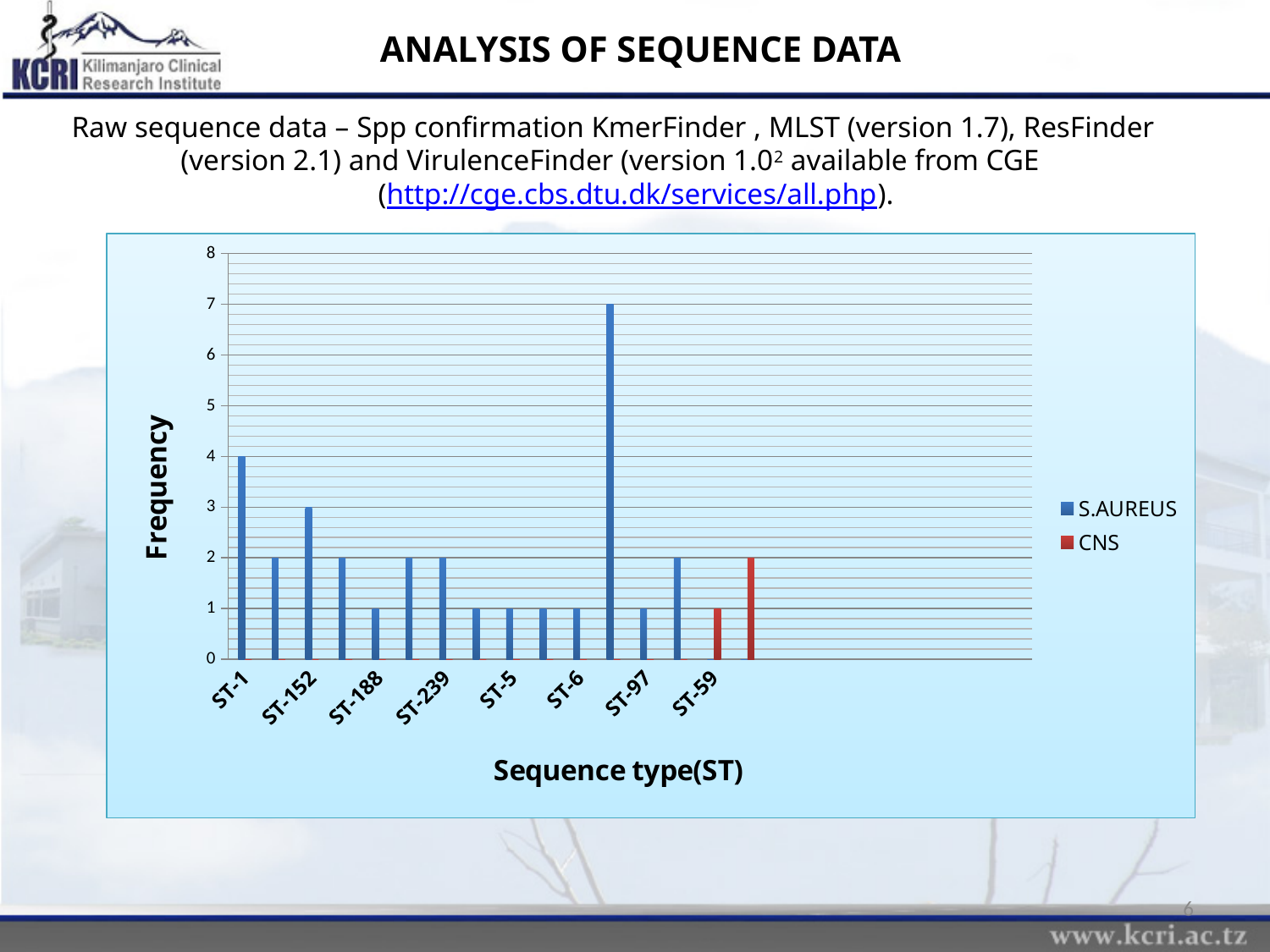
How many series does the chart legend list? 2 How many bars are plotted in the chart in total? 16 What are the two series named in the chart legend? S.AUREUS and CNS What is the title of the chart's x axis? Sequence type(ST) What type of chart is shown on the slide? bar chart Is the frequency for ST-1 greater or less than 3? greater What is the frequency for ST-152? 3 What is the difference in frequency between ST-1 and ST-152? 1 What is the highest frequency value reached by any bar in the chart? 7 Which has the larger frequency, ST-1 or ST-152? ST-1 What is the frequency for ST-1? 4 What is the frequency for ST-59? 1